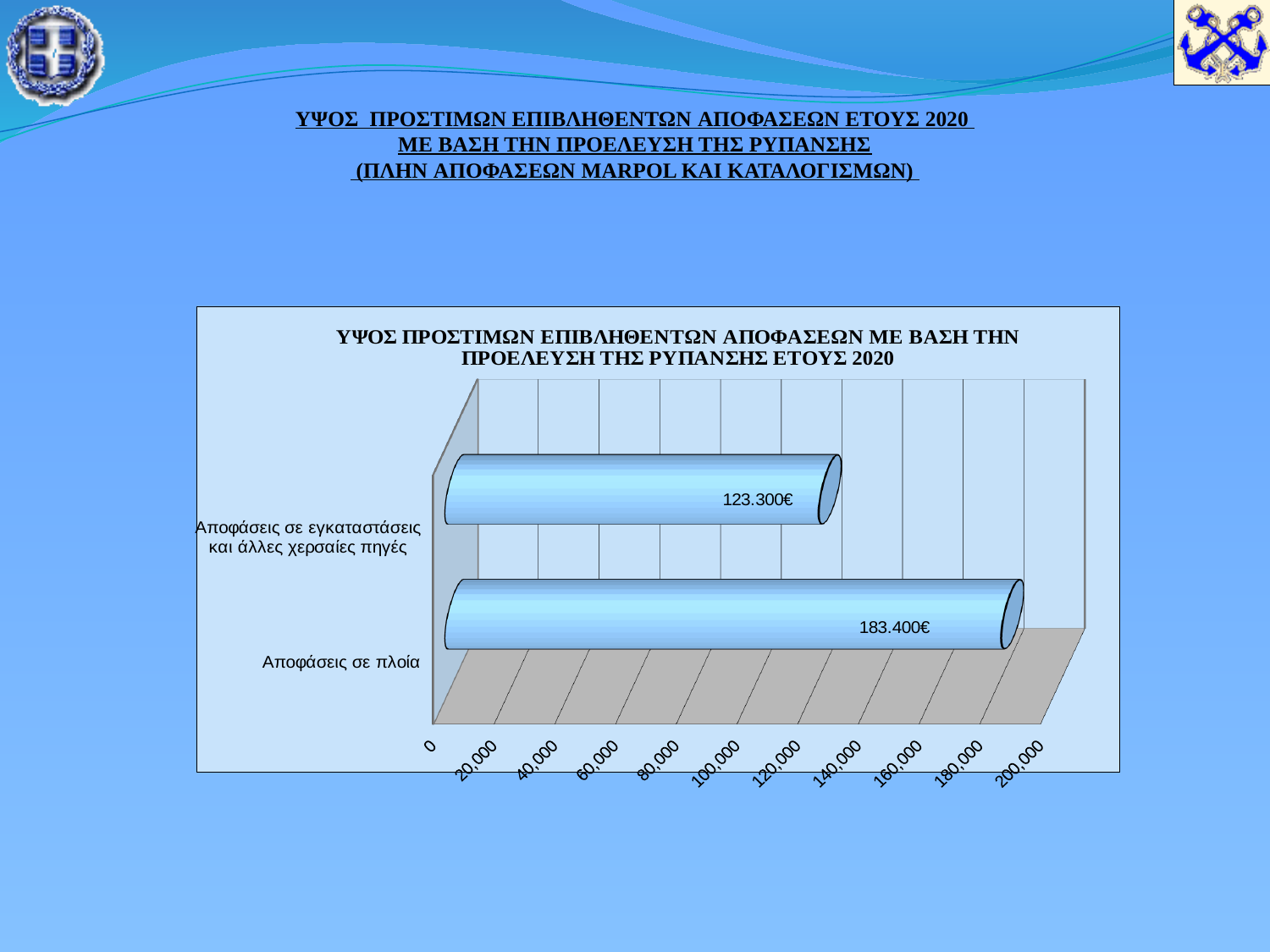
Is the value for "Αποφάσεις σε εγκαταστάσεις και άλλες χερσαίες πηγές" greater or less than 140,000? less What is the fine amount shown for "Αποφάσεις σε εγκαταστάσεις και άλλες χερσαίες πηγές"? 123.300€ Which category has the higher fine amount? Αποφάσεις σε πλοία Which category has the lower fine amount? Αποφάσεις σε εγκαταστάσεις και άλλες χερσαίες πηγές What is the difference between the fine amount for "Αποφάσεις σε πλοία" and the fine amount for "Αποφάσεις σε εγκαταστάσεις και άλλες χερσαίες πηγές"? 60.100€ How many categories are shown in the chart? 2 Is the value for "Αποφάσεις σε πλοία" greater or less than 160,000? greater What year does the chart title refer to? 2020 What is the fine amount shown for "Αποφάσεις σε πλοία"? 183.400€ What is the maximum value shown on the horizontal axis of the chart? 200,000 What type of chart is shown on the slide? Bar chart Is the fine amount for "Αποφάσεις σε πλοία" larger or smaller than the fine amount for "Αποφάσεις σε εγκαταστάσεις και άλλες χερσαίες πηγές"? larger